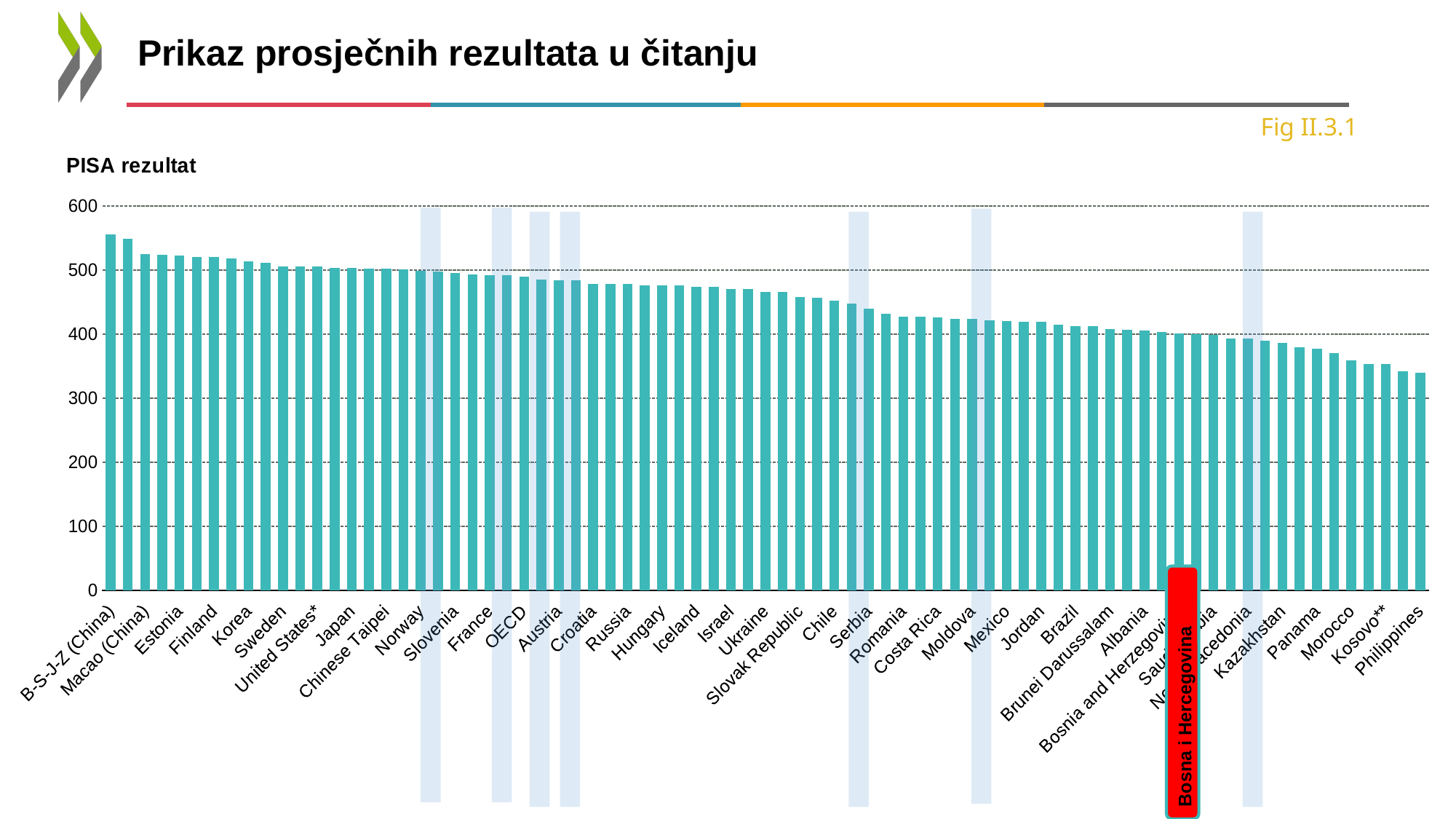
Is the value for B-S-J-Z (China) greater or less than 500? greater Is the value for Serbia greater or less than 500? less What is the title of the chart on the slide? Prikaz prosječnih rezultata u čitanju Do the bar values rise or fall from left to right along the x axis? fall What kind of chart is shown on the slide? bar chart Which category has the highest bar in the chart? B-S-J-Z (China) Is the value for Morocco greater or less than 400? less Which has the larger value, Finland or Croatia? Finland Which category has the lowest bar in the chart? Philippines What label is shown on the vertical axis of the chart? PISA rezultat